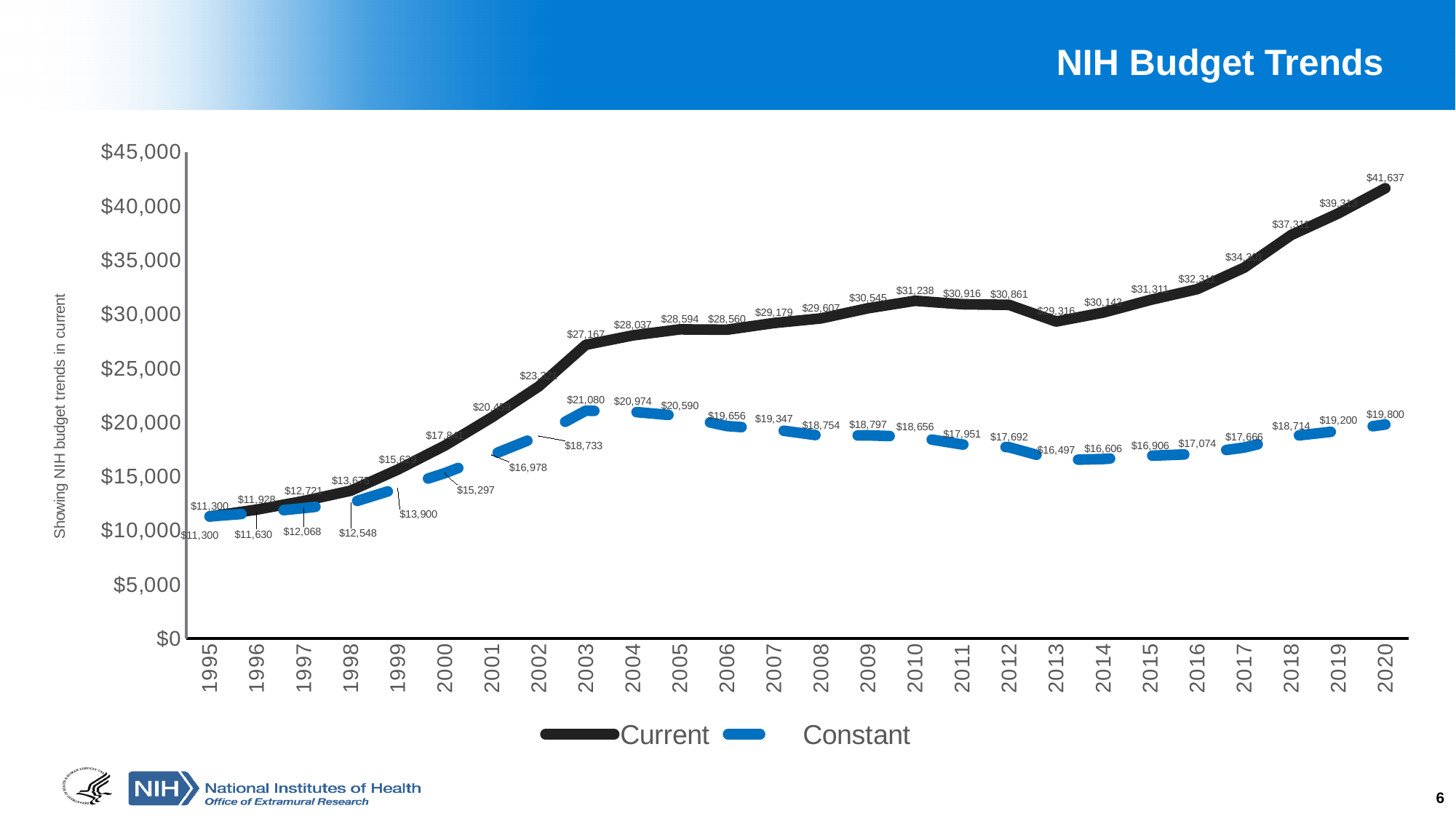
How many series does the legend list? 2 Is the Current value for 2016 greater or less than $30,000? greater What is the Constant value for 2013? $16,497 What is the Current value for 2013? $29,316 In which year is the Constant series lowest? 1995 What kind of chart is shown on the slide? line chart Which is larger, the Current value for 2010 or for 2011? 2010 What is the difference between the Current and Constant values in 2020? $21,837 In which year is the Current series highest? 2020 In which year is the Constant series highest? 2003 What is the Current value for 2020? $41,637 How many years are shown on the x axis? 26